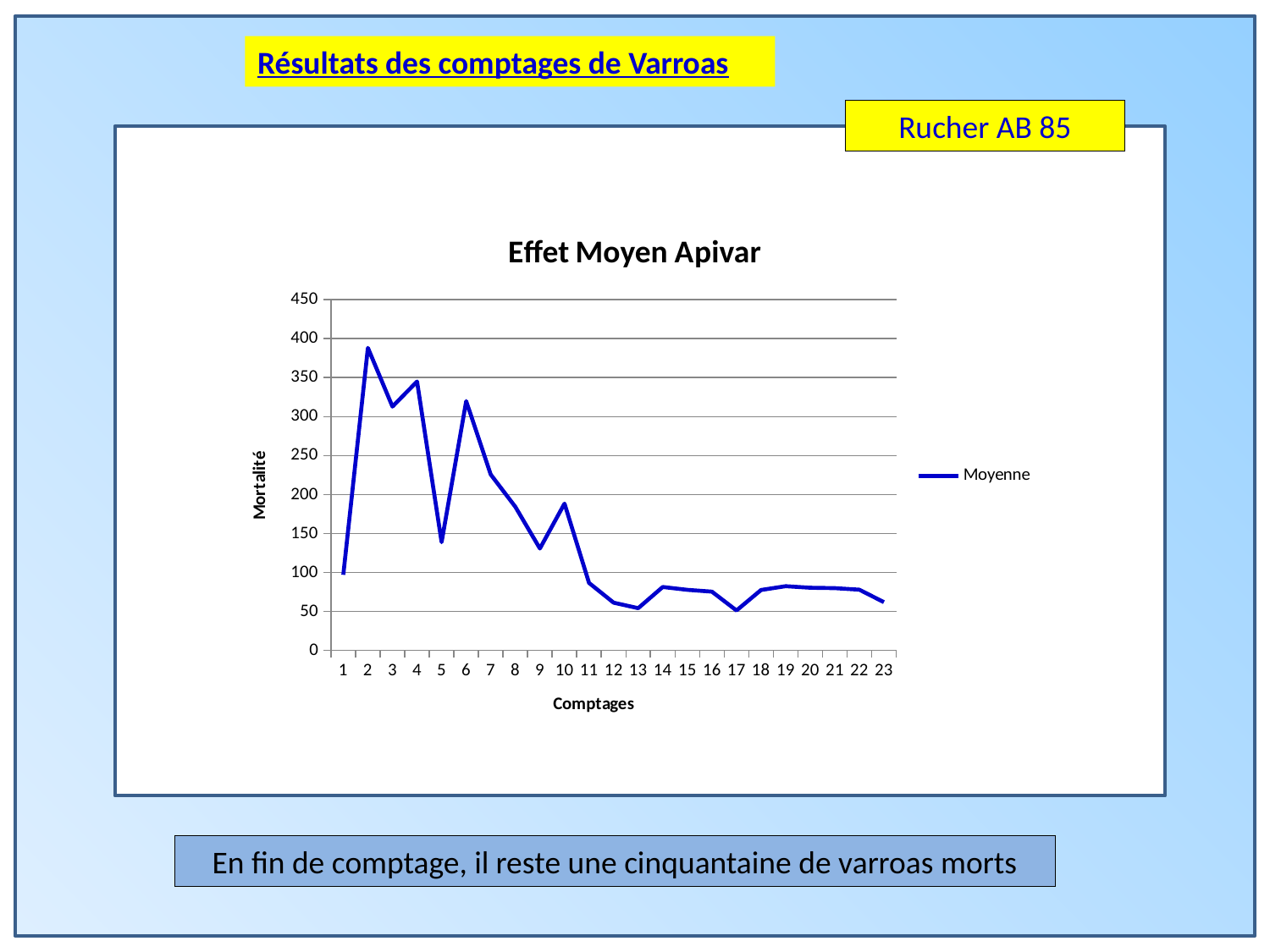
At which comptage is the Moyenne value highest? 2 Overall, do the Moyenne values rise or fall from comptage 2 to comptage 23? fall How many comptages (points) are plotted along the x axis? 23 What is the name of the series shown in the legend? Moyenne What is the title of the chart? Effet Moyen Apivar What kind of chart is shown on the slide? line chart Is the Moyenne value at comptage 2 greater or less than 350? greater How many series does the legend list? 1 Which has the larger Moyenne value, comptage 2 or comptage 4? comptage 2 Is the Moyenne value at comptage 17 greater or less than 100? less Is the Moyenne value at comptage 6 greater or less than 300? greater